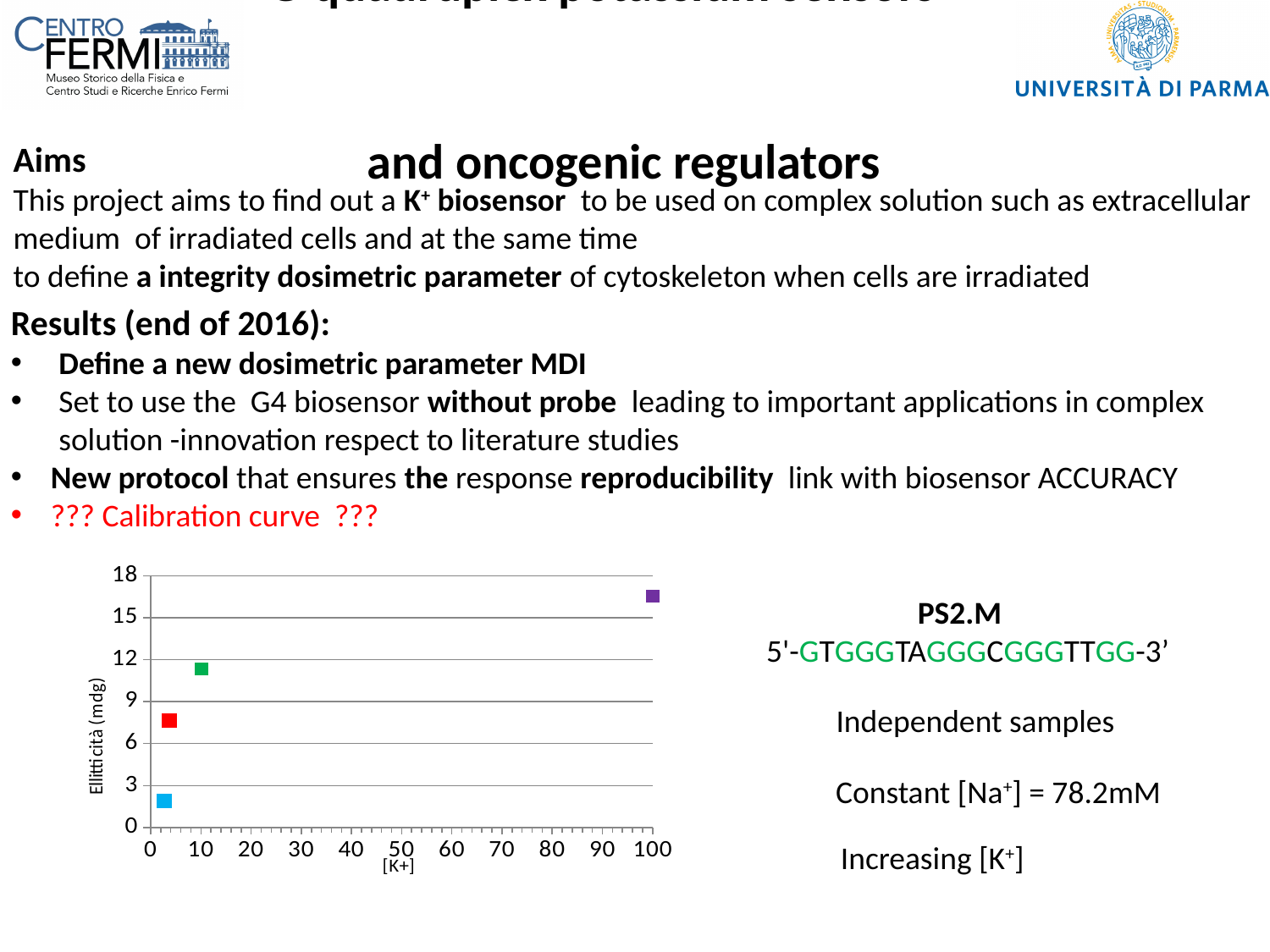
Is the Ellitticità value of the purple point greater or less than 15? greater What is the label of the y axis of the chart? Ellitticità (mdg) Is the Ellitticità value of the green point greater or less than 9? greater Is the Ellitticità value of the cyan point greater or less than 3? less What is the label of the x axis of the chart? [K+] How many data points are plotted on the chart? 4 Which point has the highest Ellitticità value: the purple point, the green point, the red point or the cyan point? the purple point Do the plotted values of Ellitticità rise or fall as [K+] increases along the x axis? rise What kind of chart is shown on the slide? scatter plot Which point has the lowest Ellitticità value: the purple point, the green point, the red point or the cyan point? the cyan point Which has the larger Ellitticità value, the green point or the red point? the green point